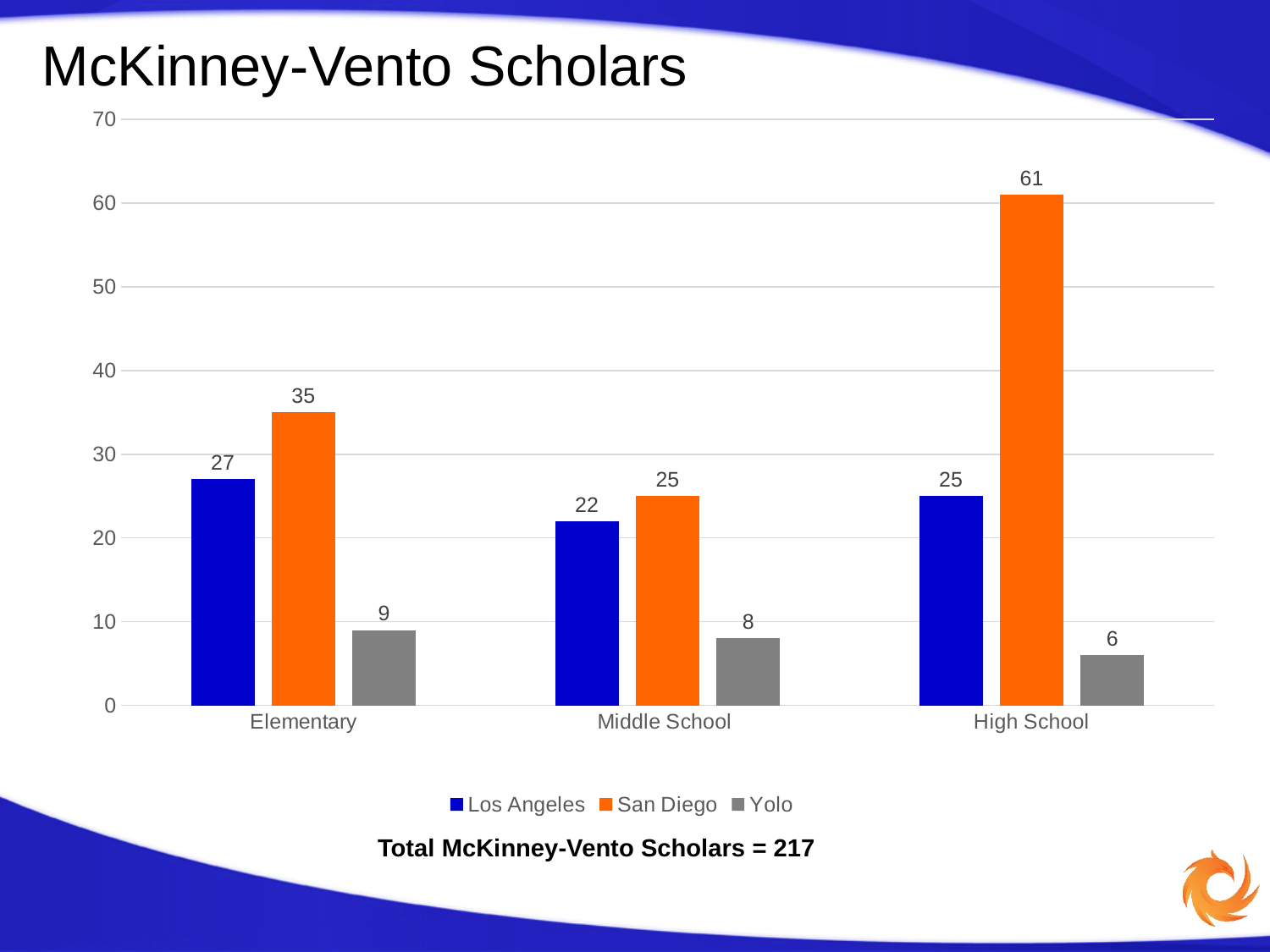
What is the value for Los Angeles in the Elementary category? 27 Do the Yolo values rise or fall from Elementary to High School? fall What is the title of the chart? McKinney-Vento Scholars What kind of chart is shown on the slide? bar chart What is the value for Yolo in the Middle School category? 8 How many series does the legend list? 3 How many categories are shown on the x axis? 3 What is the value for San Diego in the High School category? 61 Which is larger: the Los Angeles value for Elementary or the Los Angeles value for Middle School? Elementary Which category has the lowest value for Yolo? High School Which category has the highest value for San Diego? High School What is the difference between the San Diego and Los Angeles values in the Elementary category? 8